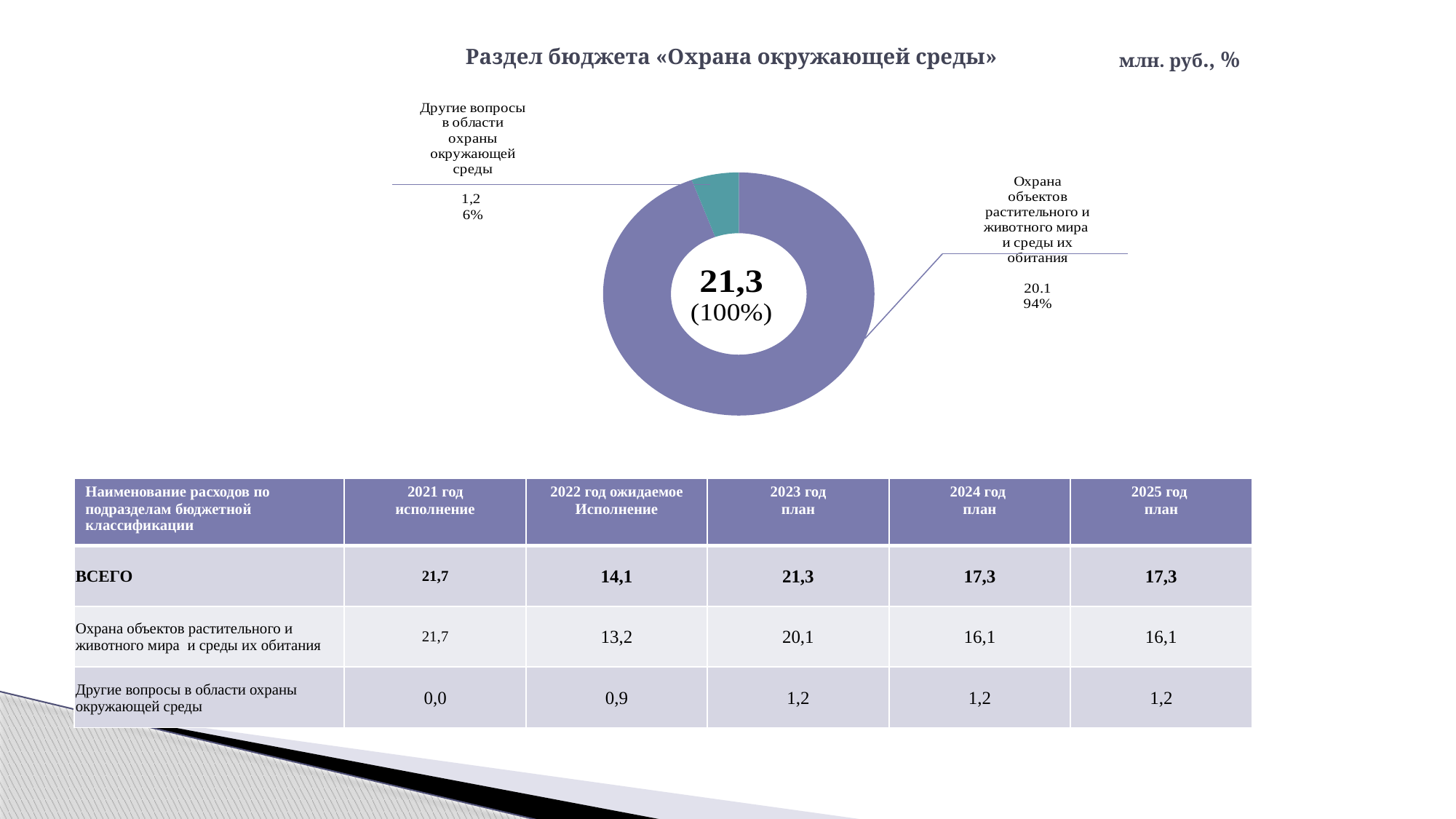
Which category has the largest slice in the donut chart? Охрана объектов растительного и животного мира и среды их обитания What percentage share does «Другие вопросы в области охраны окружающей среды» have in the donut chart? 6% Which is larger in the donut chart: the slice for «Охрана объектов растительного и животного мира и среды их обитания» or the slice for «Другие вопросы в области охраны окружающей среды»? Охрана объектов растительного и животного мира и среды их обитания What units are indicated for the chart values on the slide? млн. руб., % What total value is displayed in the centre of the donut chart? 21,3 (100%) How many slices does the donut chart have? 2 What percentage share does «Охрана объектов растительного и животного мира и среды их обитания» have in the donut chart? 94% What is the title of the chart on the slide? Раздел бюджета «Охрана окружающей среды» What is the value shown for «Другие вопросы в области охраны окружающей среды» in the donut chart? 1,2 Which category has the smallest slice in the donut chart? Другие вопросы в области охраны окружающей среды What is the value shown for «Охрана объектов растительного и животного мира и среды их обитания» in the donut chart? 20.1 What type of chart is shown on the slide? Donut (pie) chart